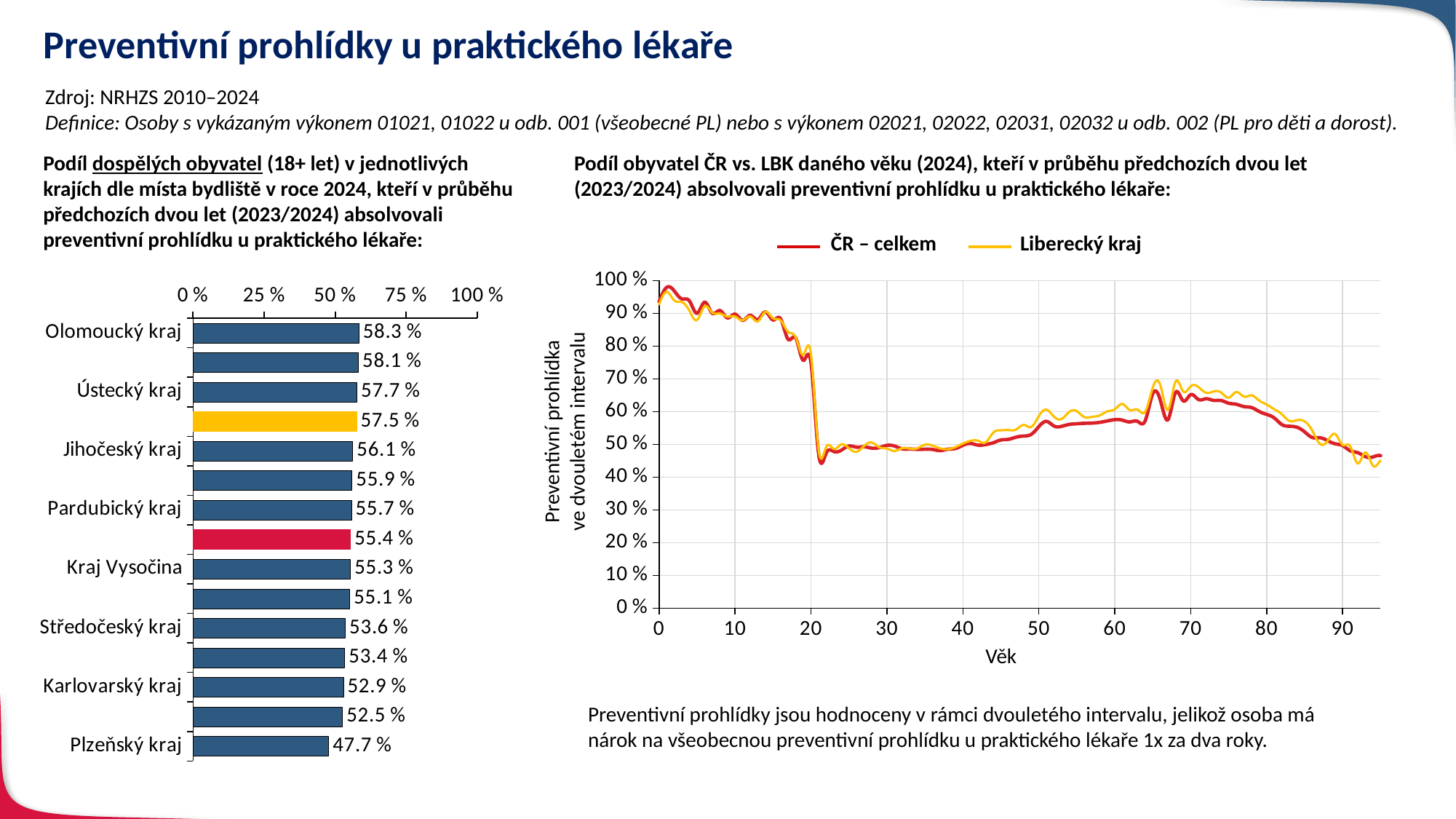
How many bars are shown in the left bar chart? 15 In the left bar chart, what is the value for Plzeňský kraj? 47.7 % In the left bar chart, what is the value for Olomoucký kraj? 58.3 % In the left bar chart, what is the difference between the values for Olomoucký kraj and Plzeňský kraj? 10.6 % In the left bar chart, which region has the highest value? Olomoucký kraj How many series does the legend of the right chart list? 2 In the right line chart, do the values rise or fall between age 70 and age 90? fall In the right line chart, is the value for ČR – celkem at age 10 greater or less than 80 %? greater In the left bar chart, what is the value for Kraj Vysočina? 55.3 % In the left bar chart, which region has the lowest value? Plzeňský kraj In the left bar chart, which is larger: the value for Ústecký kraj or the value for Karlovarský kraj? Ústecký kraj What kind of chart is the chart on the left of the slide? Bar chart